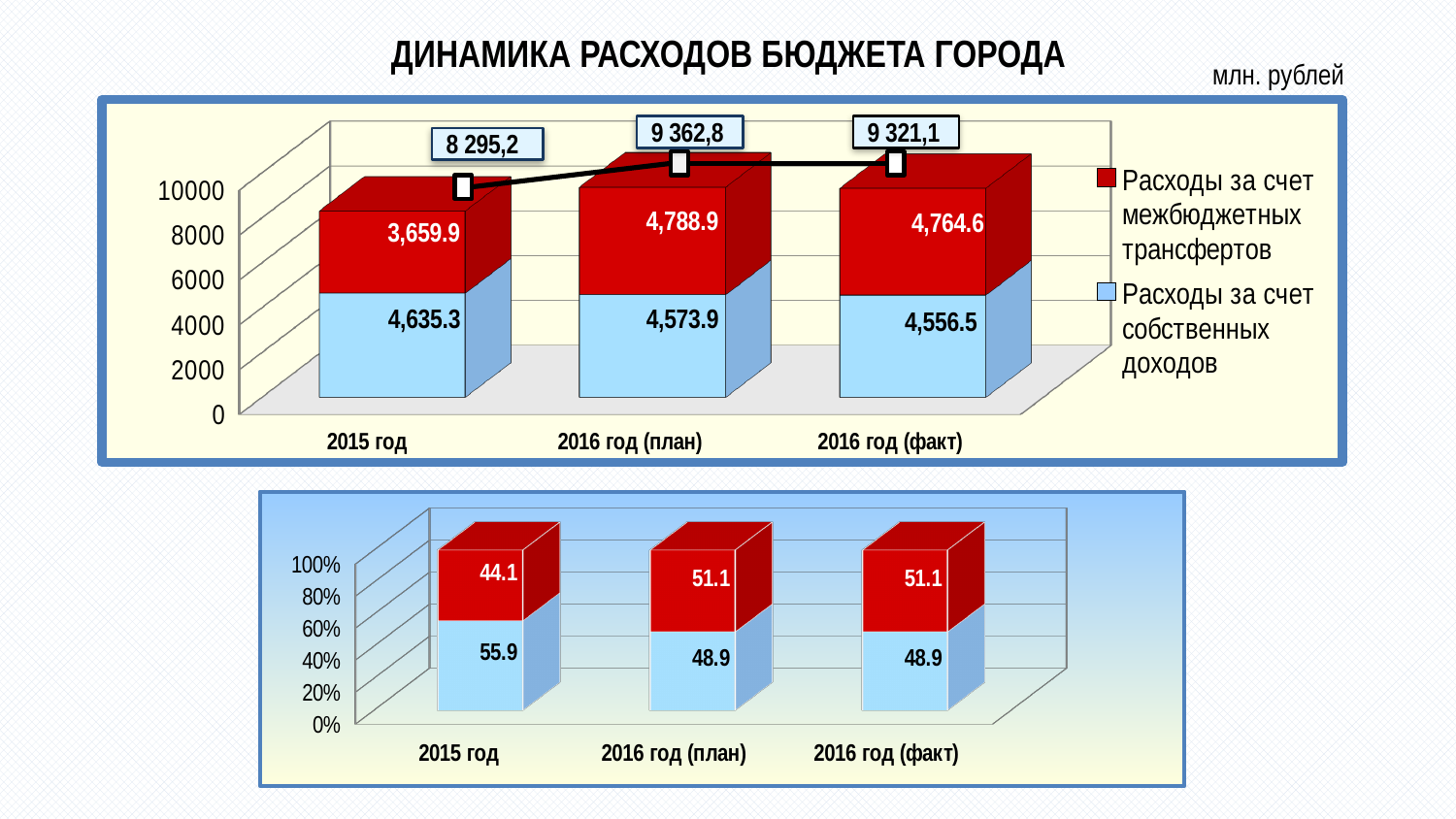
In the top chart, for 2015 год, which is larger: 'Расходы за счет собственных доходов' or 'Расходы за счет межбюджетных трансфертов'? Расходы за счет собственных доходов What kind of chart is the bottom chart? Stacked bar chart In the top chart, what total is shown above the bar for 2016 год (план)? 9 362,8 In the bottom chart, what is the share of 'Расходы за счет собственных доходов' for 2015 год? 55.9 In the bottom chart, does the share of 'Расходы за счет собственных доходов' rise or fall from 2015 год to 2016 год (план)? Fall In the top chart, which year has the highest total expenditure? 2016 год (план) In the top chart, which year has the lowest value for 'Расходы за счет межбюджетных трансфертов'? 2015 год How many series does the legend of the top chart list? 2 In the top chart, what is the value of 'Расходы за счет межбюджетных трансфертов' for 2015 год? 3,659.9 In the top chart, what is the value of 'Расходы за счет собственных доходов' for 2016 год (факт)? 4,556.5 How many categories are shown on the x axis of the top chart? 3 In the top chart, what is the difference between 'Расходы за счет межбюджетных трансфертов' for 2016 год (план) and 2016 год (факт)? 24.3